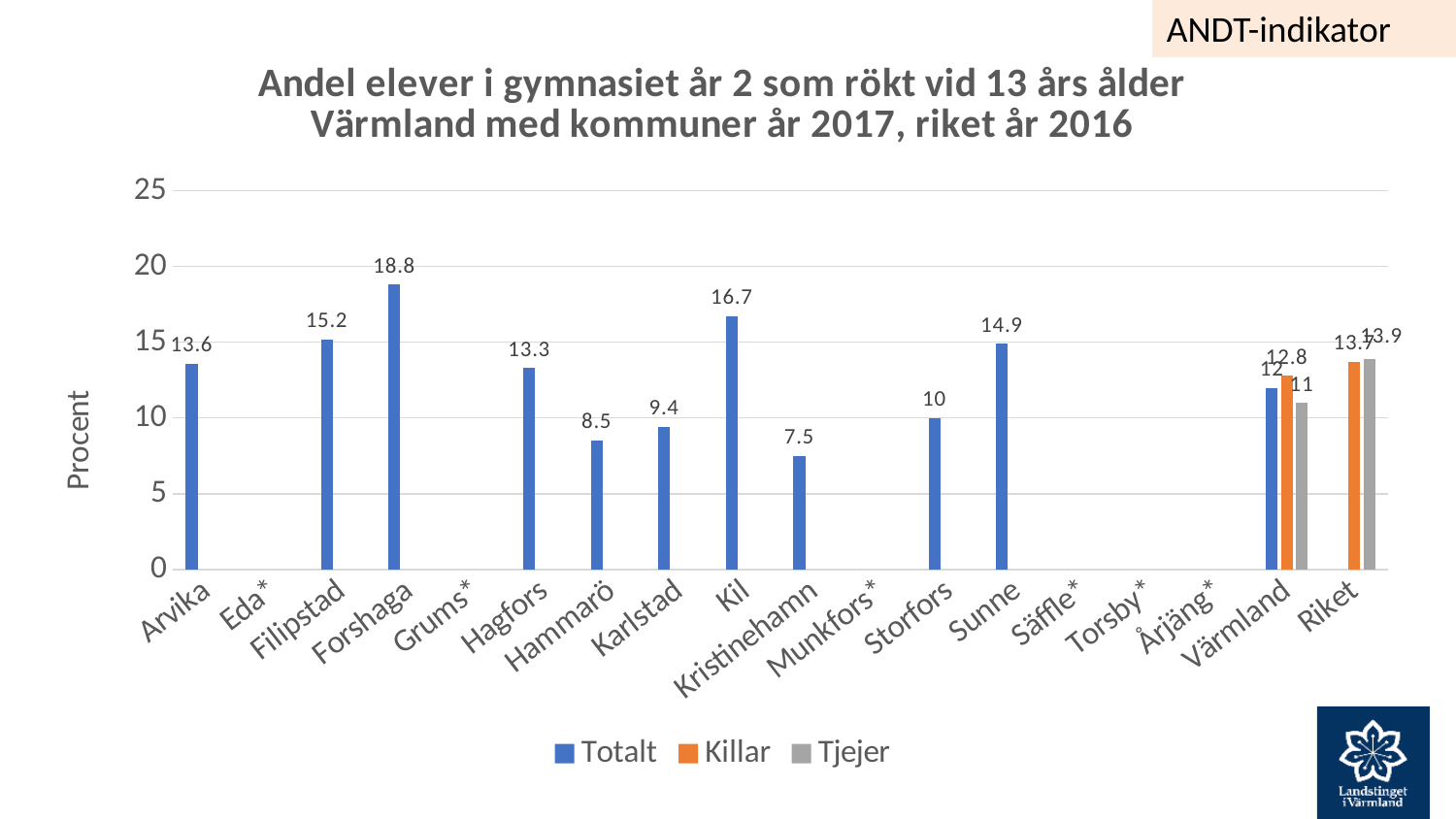
Which has a higher Totalt value, Filipstad or Sunne? Filipstad What kind of chart is shown on the slide? Bar chart How many categories are shown on the x axis? 18 Is the Totalt value for Storfors greater or less than 15? less What is the Tjejer value for Värmland? 11 What is the Totalt value for Forshaga? 18.8 What is the difference between the Totalt values for Kil and Hagfors? 3.4 Which category has the lowest plotted Totalt value? Kristinehamn How many series does the legend list? 3 Which municipality has the highest Totalt value? Forshaga What is the Totalt value for Kristinehamn? 7.5 What is the Killar value for Värmland? 12.8